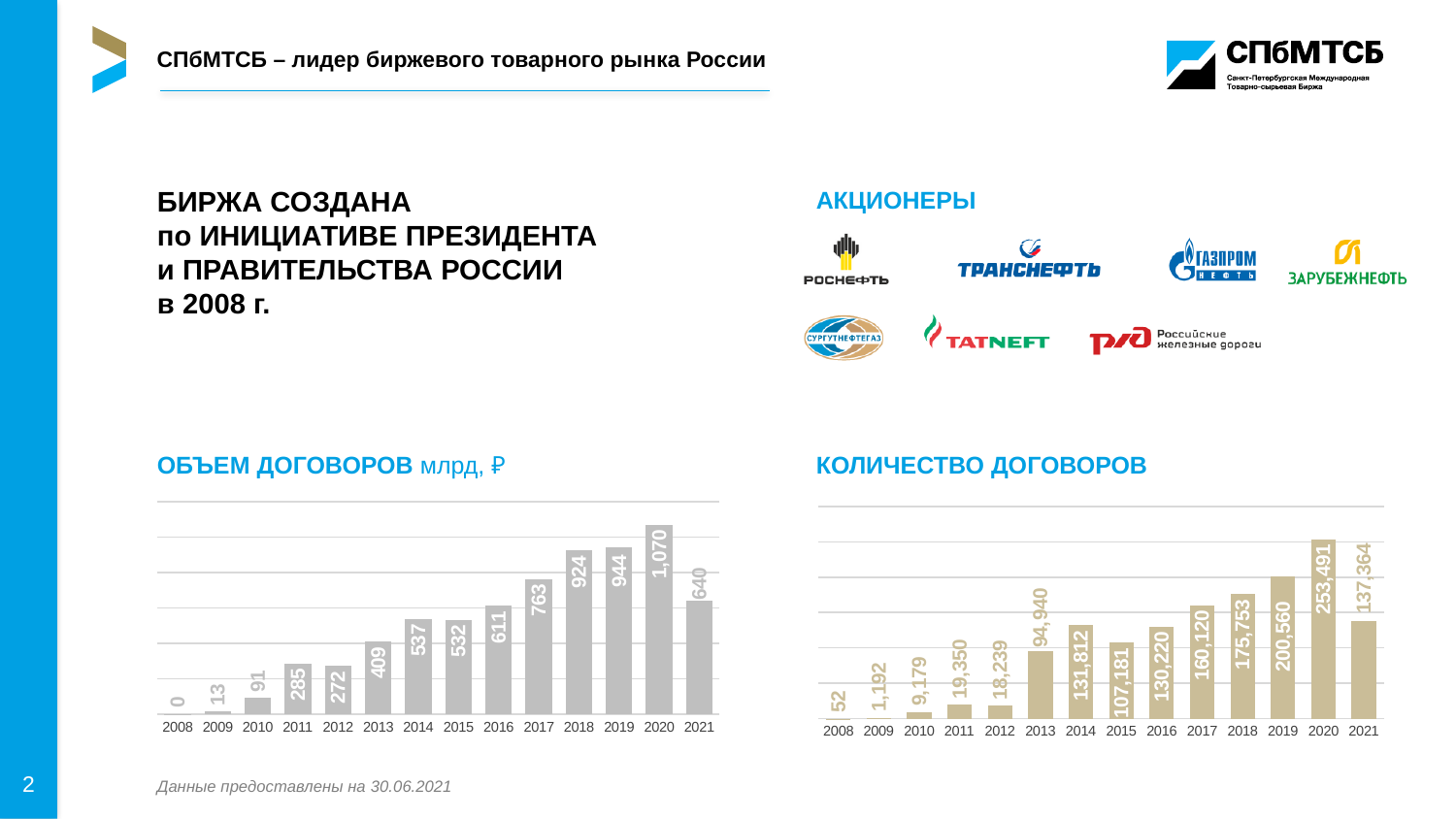
In the 'КОЛИЧЕСТВО ДОГОВОРОВ' chart, what is the difference between the values for 2014 and 2015? 24,631 In the 'ОБЪЕМ ДОГОВОРОВ' chart, which year has the highest value? 2020 In the 'КОЛИЧЕСТВО ДОГОВОРОВ' chart, which year has the highest value? 2020 In the 'ОБЪЕМ ДОГОВОРОВ' chart, what is the value for 2017? 763 In the 'КОЛИЧЕСТВО ДОГОВОРОВ' chart, what is the value for 2019? 200,560 In the 'ОБЪЕМ ДОГОВОРОВ' chart, what is the value for 2020? 1,070 In the 'ОБЪЕМ ДОГОВОРОВ' chart, what is the difference between the values for 2020 and 2021? 430 In the 'КОЛИЧЕСТВО ДОГОВОРОВ' chart, what is the value for 2008? 52 What type of chart is the 'КОЛИЧЕСТВО ДОГОВОРОВ' chart? Bar chart In the 'ОБЪЕМ ДОГОВОРОВ' chart, what unit is stated in the chart title? млрд, ₽ In the 'ОБЪЕМ ДОГОВОРОВ' chart, which is larger, the value for 2011 or the value for 2012? 2011 In the 'ОБЪЕМ ДОГОВОРОВ' chart, how many years are shown on the x axis? 14